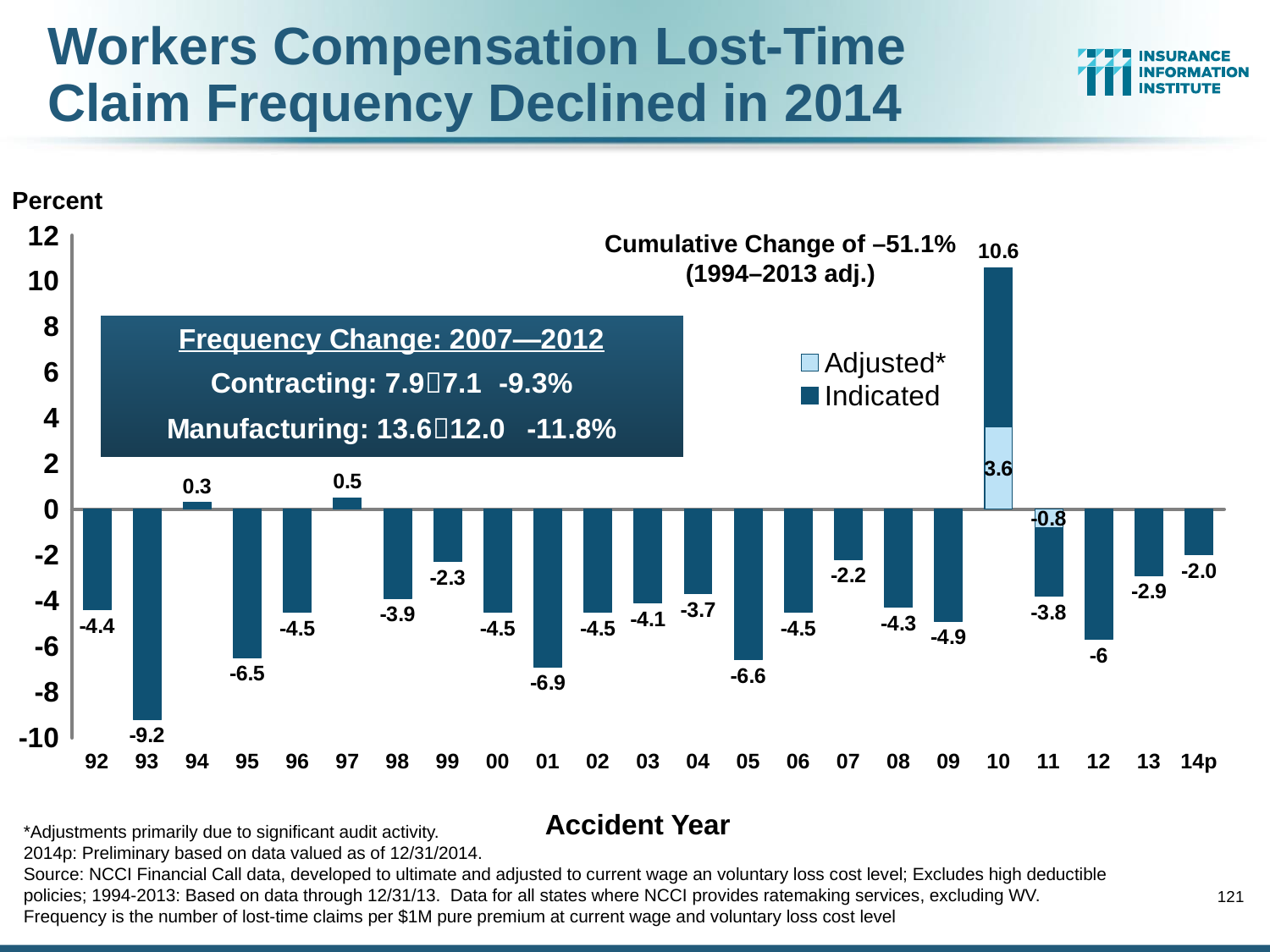
How many series does the legend list? 2 Which accident year has a larger value, 97 or 94? 97 Which accident year has the lowest value? 93 How many accident years are shown on the x axis? 23 What is the Adjusted value for accident year 10? 3.6 Which accident year has the highest value? 10 What is the difference between the values for accident years 01 and 12? 0.9 What is the value for accident year 14p? -2.0 What is the Adjusted value for accident year 11? -0.8 What is the value for accident year 93? -9.2 What is the Indicated value for accident year 10? 10.6 What kind of chart is shown on the slide? Bar chart